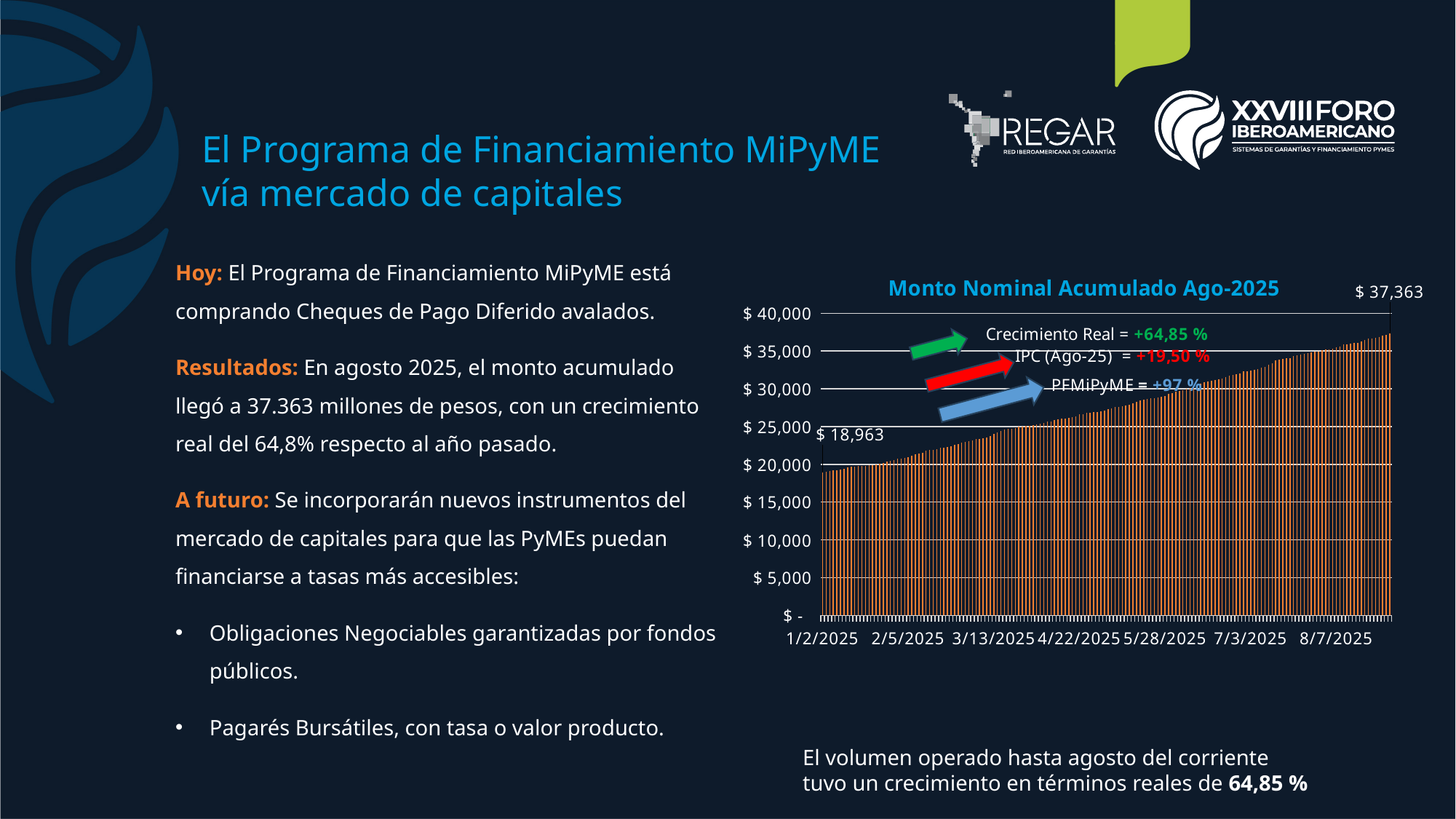
Is the value for 7/3/2025 greater or less than $ 30,000? greater Is the value for 3/13/2025 greater or less than $ 25,000? less Which is larger, the value at the start of the series or the value at the end of the series? the value at the end of the series What is the lowest labelled value in the chart? $ 18,963 What is the highest value shown on the y axis? $ 40,000 What kind of chart is shown on the slide? bar chart What is the value labelled at the end of the series (August 2025)? $ 37,363 What is the title of the chart? Monto Nominal Acumulado Ago-2025 What is the highest labelled value in the chart? $ 37,363 What is the value labelled at the start of the series (1/2/2025)? $ 18,963 What is the difference between the final labelled value ($ 37,363) and the initial labelled value ($ 18,963)? $ 18,400 Do the values rise or fall along the x axis from January to August 2025? rise